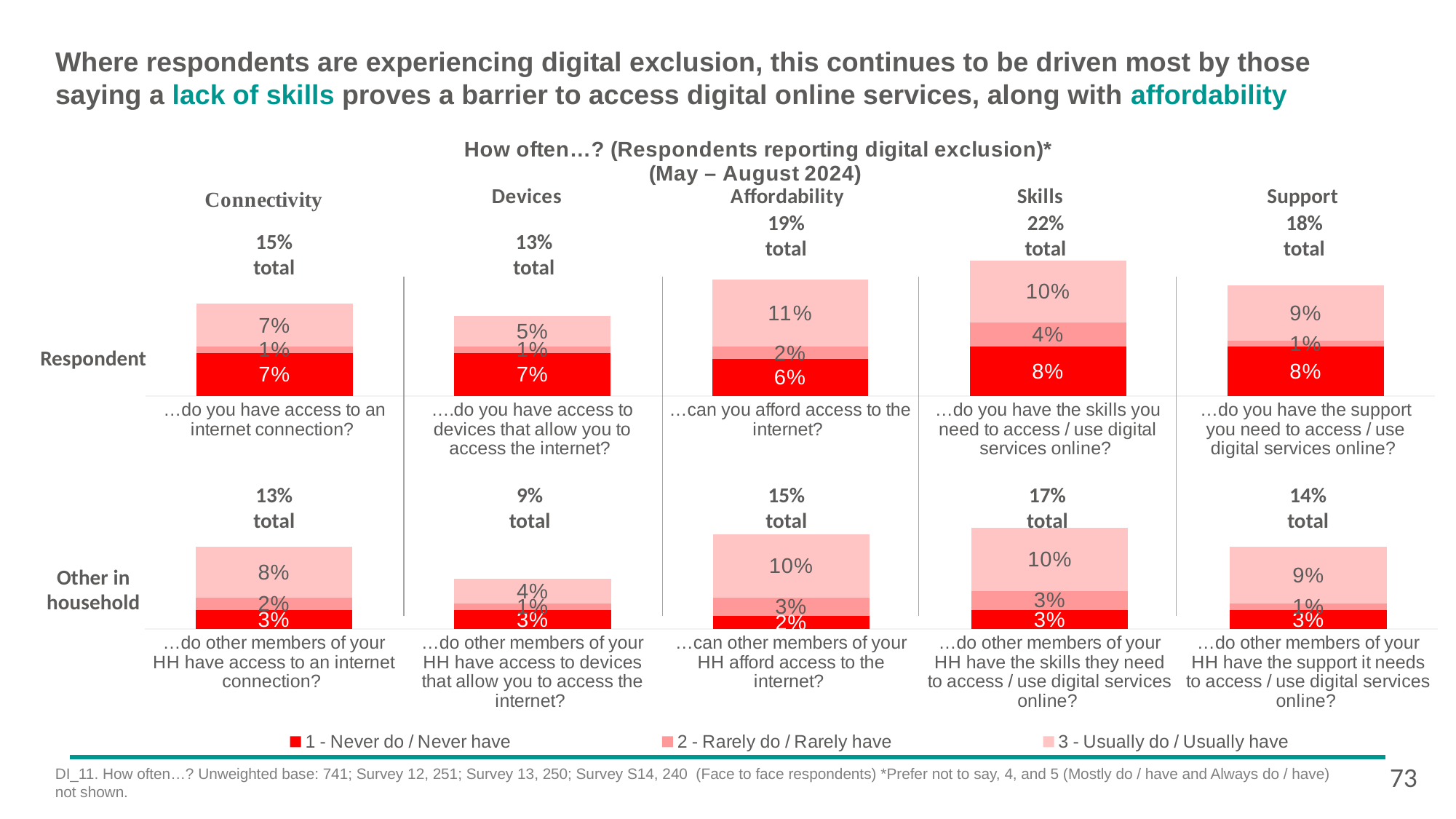
In the Other in household row, what is the '3 - Usually do / Usually have' value for Connectivity? 8% In the Other in household row, which of the five areas has the lowest total? Devices Which legend entry is shown in the darkest red colour? 1 - Never do / Never have In the Respondent row, what is the difference between the Skills total and the Devices total? 9% In the Respondent row, what is the '1 - Never do / Never have' value for Affordability? 6% In the Respondent row, what is the '2 - Rarely do / Rarely have' value for Skills? 4% What kind of chart is used to show the Respondent results for Support? stacked bar chart In the Respondent row, which of the five areas has the highest total? Skills In the Respondent row, what is the total for Skills? 22% In the Other in household row, what is the total for Support? 14% Is the Respondent total for Affordability larger or smaller than the Other in household total for Affordability? larger How many series does the legend list? 3